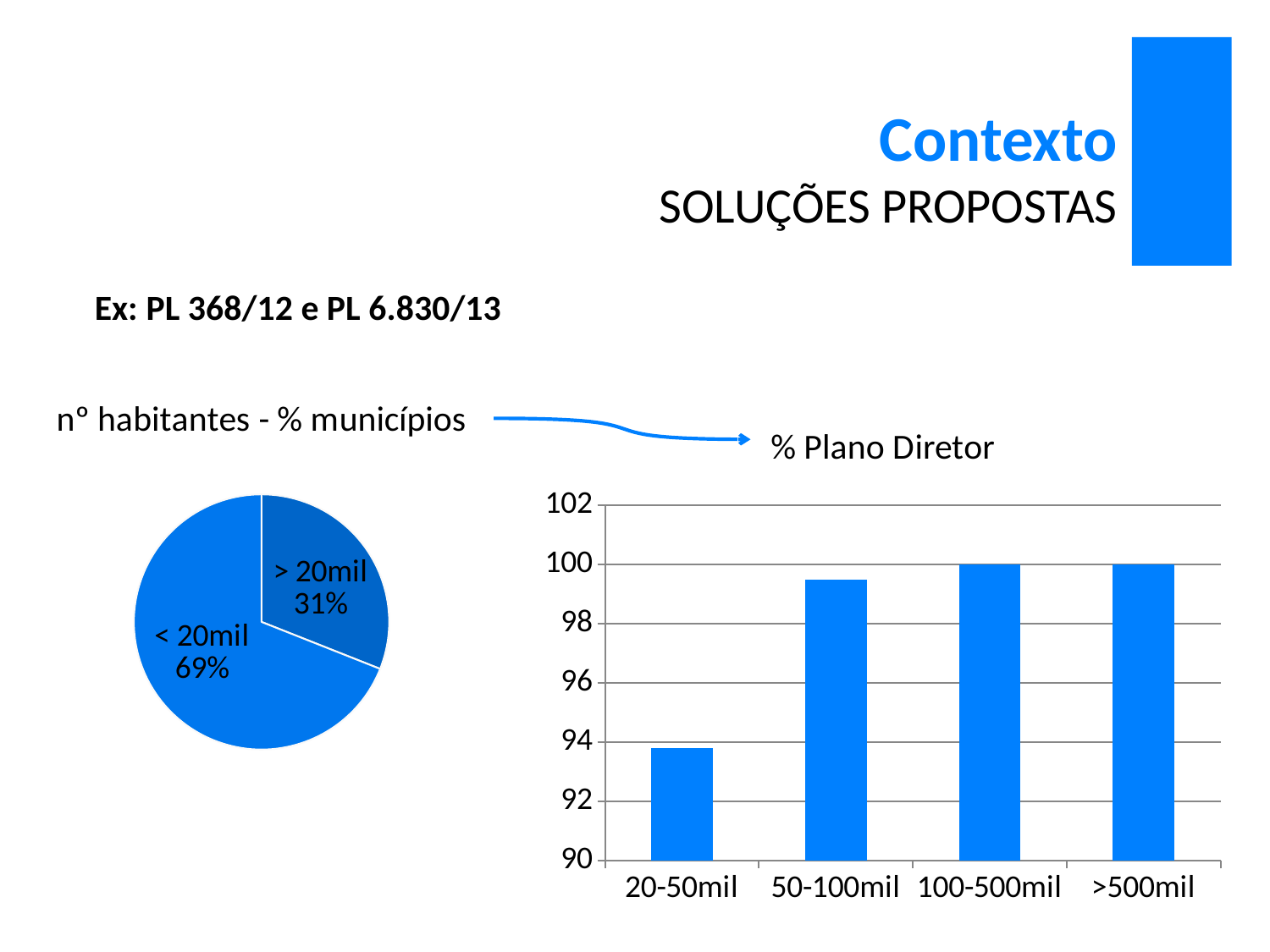
In the pie chart on the left, what share of municipalities have fewer than 20 thousand inhabitants (< 20mil)? 69% What kind of chart is the '% Plano Diretor' chart on the right? bar chart In the '% Plano Diretor' bar chart, is the value for 50-100mil greater or less than 98? greater In the '% Plano Diretor' bar chart, do the values generally rise or fall from 20-50mil to >500mil? rise In the pie chart on the left, what is the difference in percentage points between the < 20mil slice and the > 20mil slice? 38% In the pie chart on the left, what share of municipalities have more than 20 thousand inhabitants (> 20mil)? 31% In the pie chart on the left, which slice is the largest? < 20mil In the '% Plano Diretor' bar chart, what is the value for 100-500mil? 100 In the '% Plano Diretor' bar chart, how many categories are shown on the x axis? 4 In the '% Plano Diretor' bar chart, which category has the lowest value? 20-50mil In the pie chart on the left, how many slices are there? 2